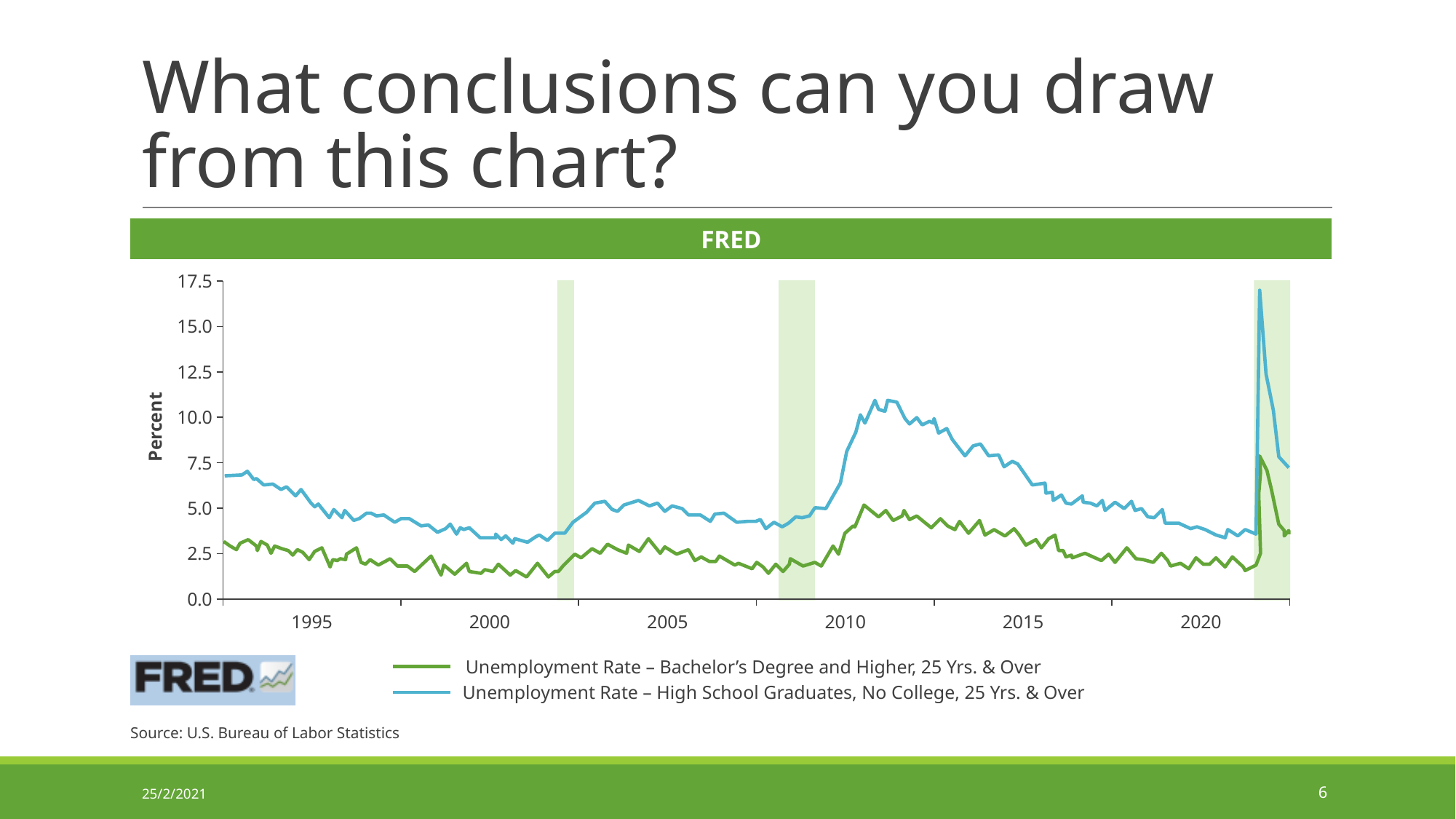
Which series has the higher unemployment rate across the whole period, Bachelor's Degree and Higher or High School Graduates, No College? High School Graduates, No College Is the value of the High School Graduates, No College series in 1995 greater or less than 5.0? greater Is the peak value of the Bachelor's Degree and Higher series around 2020 greater or less than 10.0? less Is the value of the Bachelor's Degree and Higher series in 2000 greater or less than 2.5? less What is the label on the y axis of the chart? Percent Between 2011 and 2019, does the High School Graduates, No College series rise or fall? fall What kind of chart is shown on the slide? line chart Which series is shown by the blue line? Unemployment Rate – High School Graduates, No College, 25 Yrs. & Over How many series does the legend list? 2